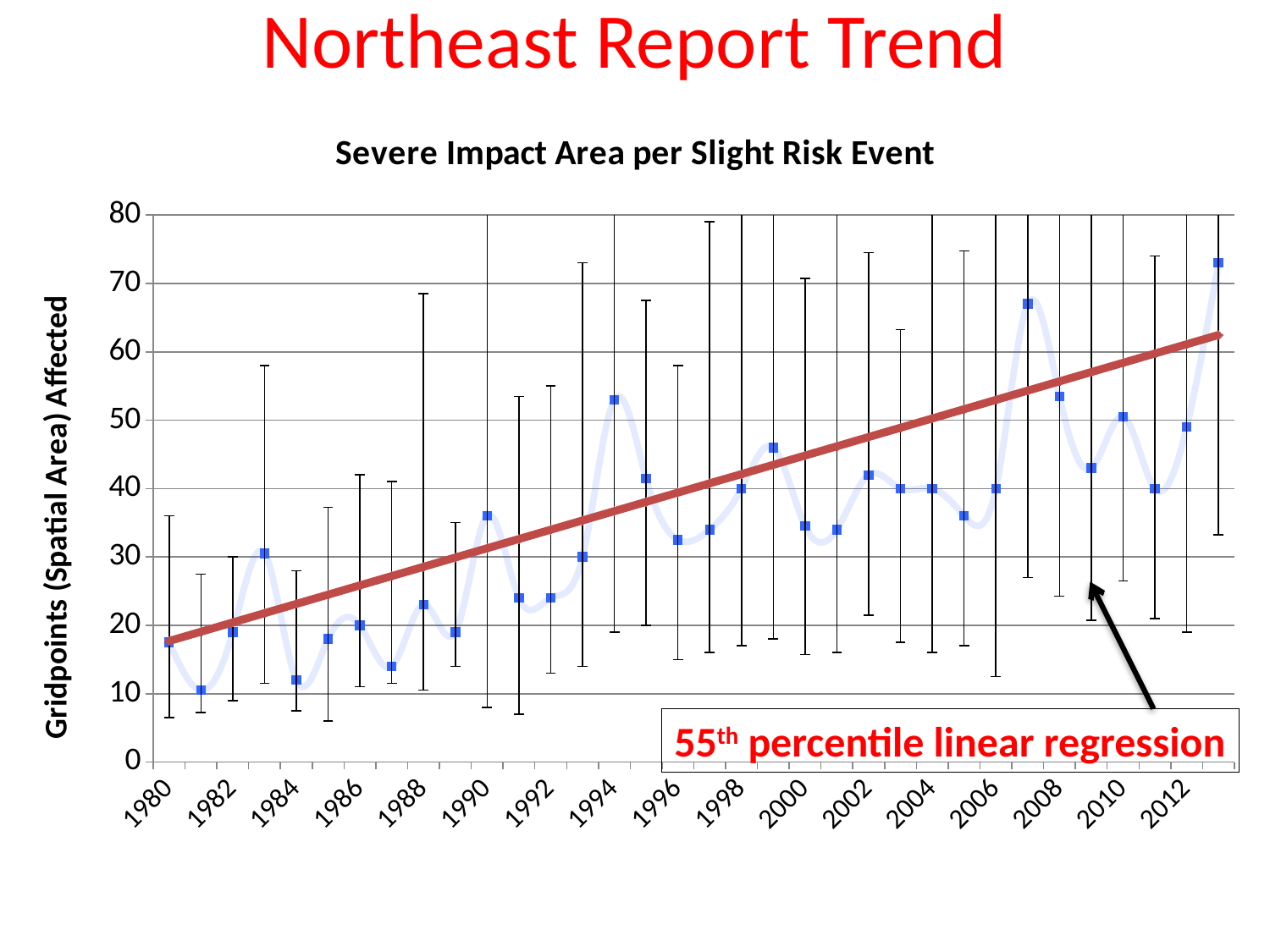
What is the title of the chart? Severe Impact Area per Slight Risk Event Is the value for 1994 greater or less than 50? greater Which is larger, the value for 2007 or the value for 2008? 2007 What kind of chart is shown on the slide? line chart Does the red regression line rise or fall from 1980 to 2013? rise Is the value for 2007 greater or less than 60? greater Is the value for 1987 greater or less than 20? less What is the label of the y axis? Gridpoints (Spatial Area) Affected Which year has the highest plotted value? 2013 Which is larger, the value for 1994 or the value for 1995? 1994